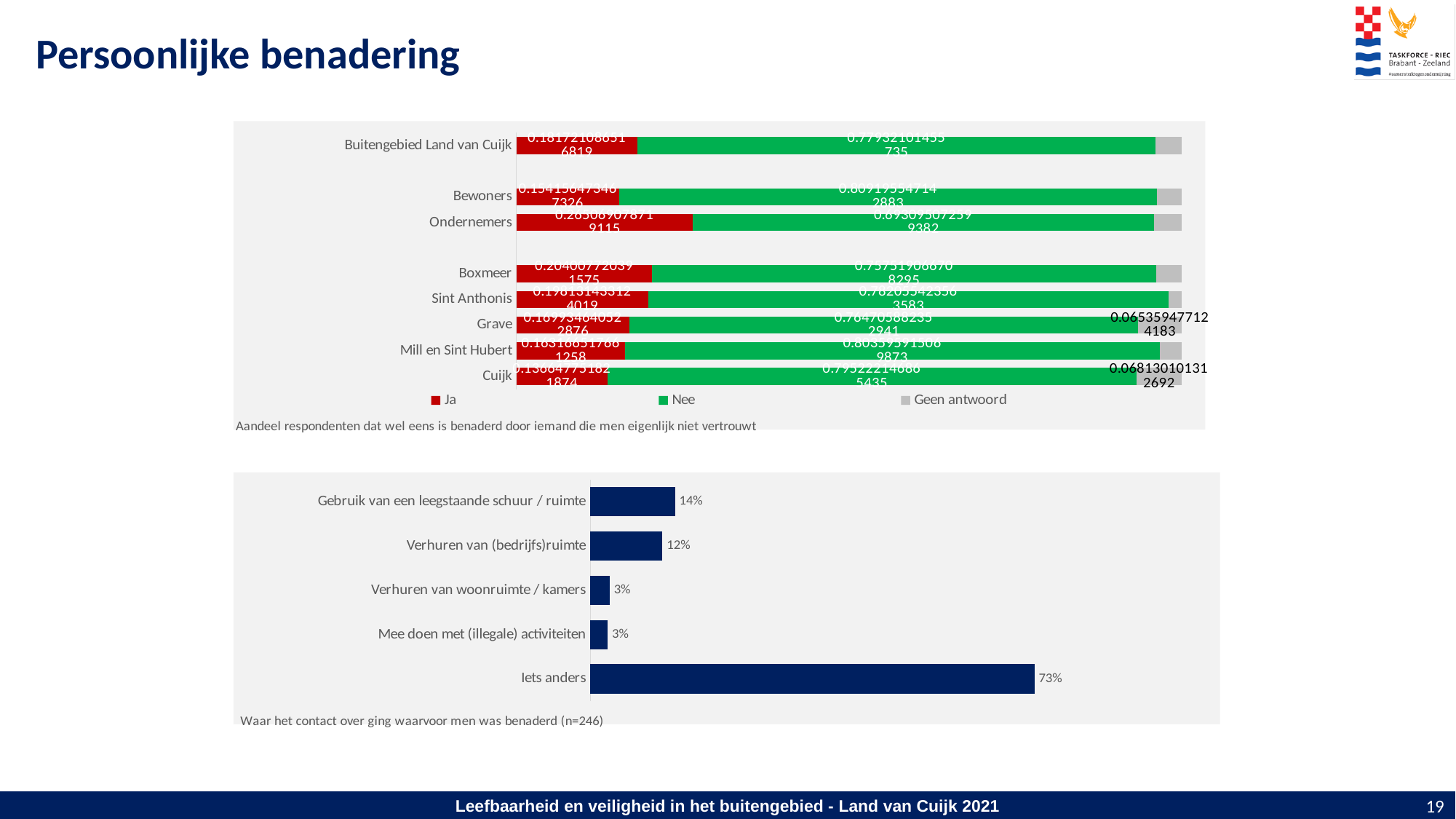
How many categories are shown in the bottom chart? 5 How many series does the legend of the top chart list? 3 In the bottom chart, which category has the highest percentage? Iets anders In the bottom chart, which is larger: 'Gebruik van een leegstaande schuur / ruimte' or 'Verhuren van (bedrijfs)ruimte'? Gebruik van een leegstaande schuur / ruimte In the bottom chart, what is the difference in percentage points between 'Iets anders' and 'Gebruik van een leegstaande schuur / ruimte'? 59 How many categories are shown in the top chart? 8 In the top chart, which category has the largest 'Ja' share? Ondernemers In the bottom chart, what percentage is shown for 'Iets anders'? 73% In the bottom chart, what percentage is shown for 'Gebruik van een leegstaande schuur / ruimte'? 14% In the bottom chart, what percentage is shown for 'Verhuren van (bedrijfs)ruimte'? 12% In the bottom chart, what percentage is shown for 'Mee doen met (illegale) activiteiten'? 3% What kind of chart is the bottom chart? Bar chart